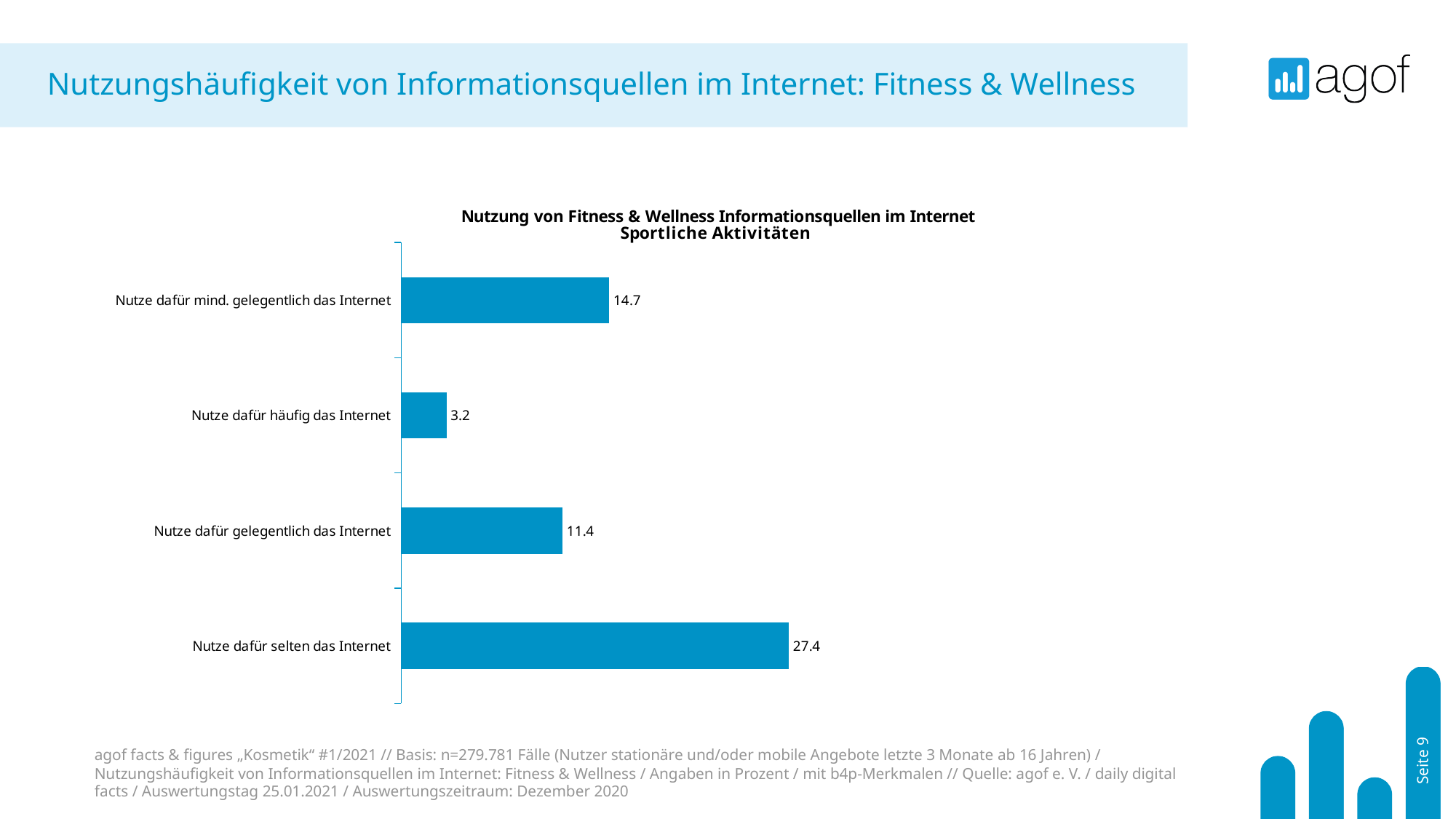
Which category has the highest value? Nutze dafür selten das Internet What is the difference between the values for "Nutze dafür selten das Internet" and "Nutze dafür mind. gelegentlich das Internet"? 12.7 What is the title of the chart? Nutzung von Fitness & Wellness Informationsquellen im Internet Sportliche Aktivitäten How many categories are shown in the chart? 4 What is the value for "Nutze dafür mind. gelegentlich das Internet"? 14.7 What is the difference between the values for "Nutze dafür gelegentlich das Internet" and "Nutze dafür häufig das Internet"? 8.2 What is the value for "Nutze dafür gelegentlich das Internet"? 11.4 Which is larger: the value for "Nutze dafür gelegentlich das Internet" or "Nutze dafür mind. gelegentlich das Internet"? Nutze dafür mind. gelegentlich das Internet What kind of chart is shown on the slide? Bar chart What is the value for "Nutze dafür häufig das Internet"? 3.2 What is the value for "Nutze dafür selten das Internet"? 27.4 Which category has the lowest value? Nutze dafür häufig das Internet